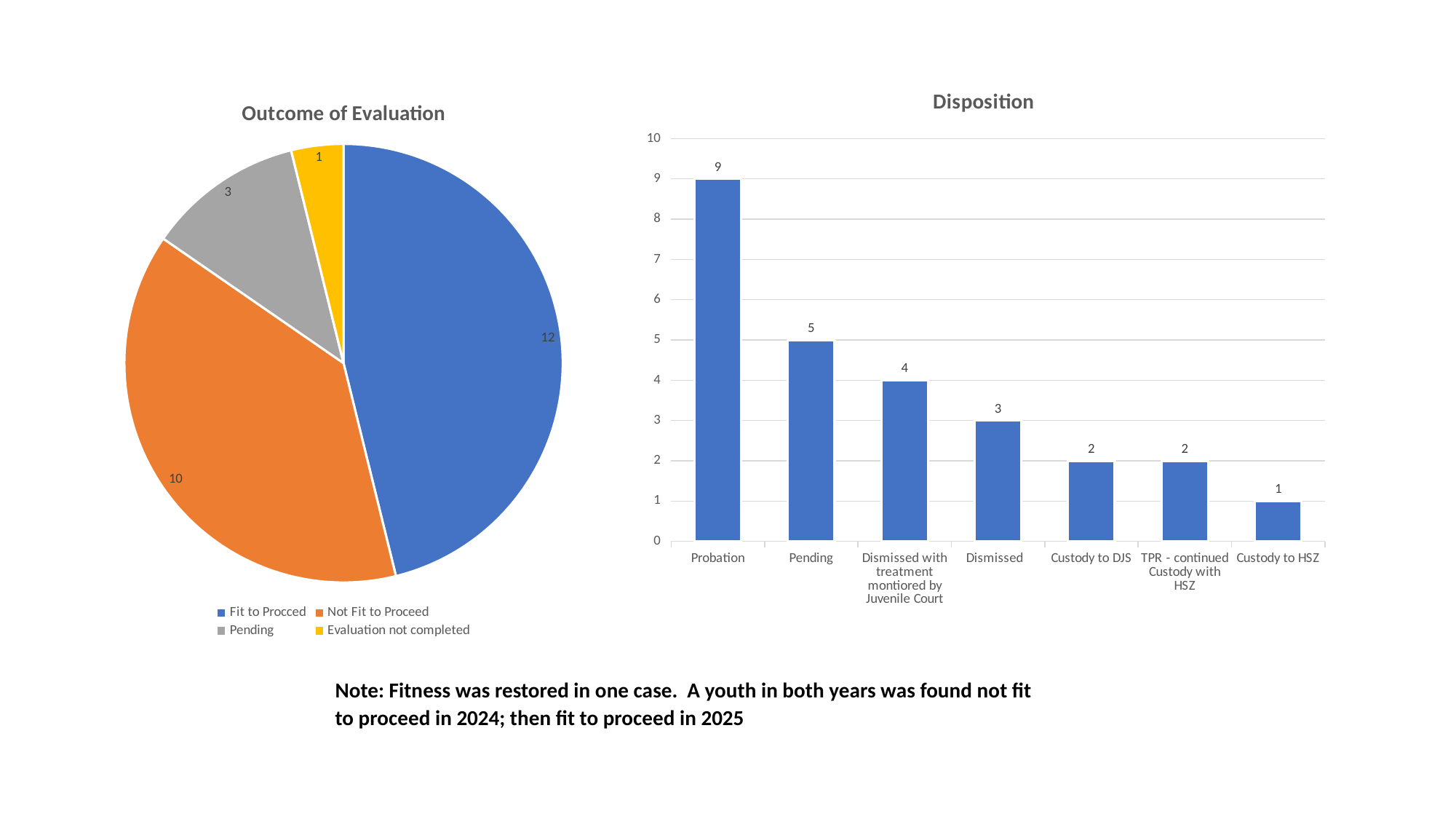
What kind of chart is "Outcome of Evaluation"? Pie chart In the "Disposition" chart, what is the value for Dismissed with treatment monitored by Juvenile Court? 4 In the "Outcome of Evaluation" chart, what is the difference between Fit to Proceed and Pending? 9 In the "Disposition" chart, what is the value for Probation? 9 What kind of chart is "Disposition"? Bar chart In the "Outcome of Evaluation" chart, which category has the smallest slice? Evaluation not completed In the "Outcome of Evaluation" chart, how many categories does the legend list? 4 In the "Disposition" chart, how many categories are shown on the x axis? 7 In the "Outcome of Evaluation" chart, what is the value for Fit to Proceed? 12 In the "Disposition" chart, what is the difference between Probation and Pending? 4 In the "Disposition" chart, which category has the lowest value? Custody to HSZ In the "Outcome of Evaluation" chart, what is the value for Not Fit to Proceed? 10